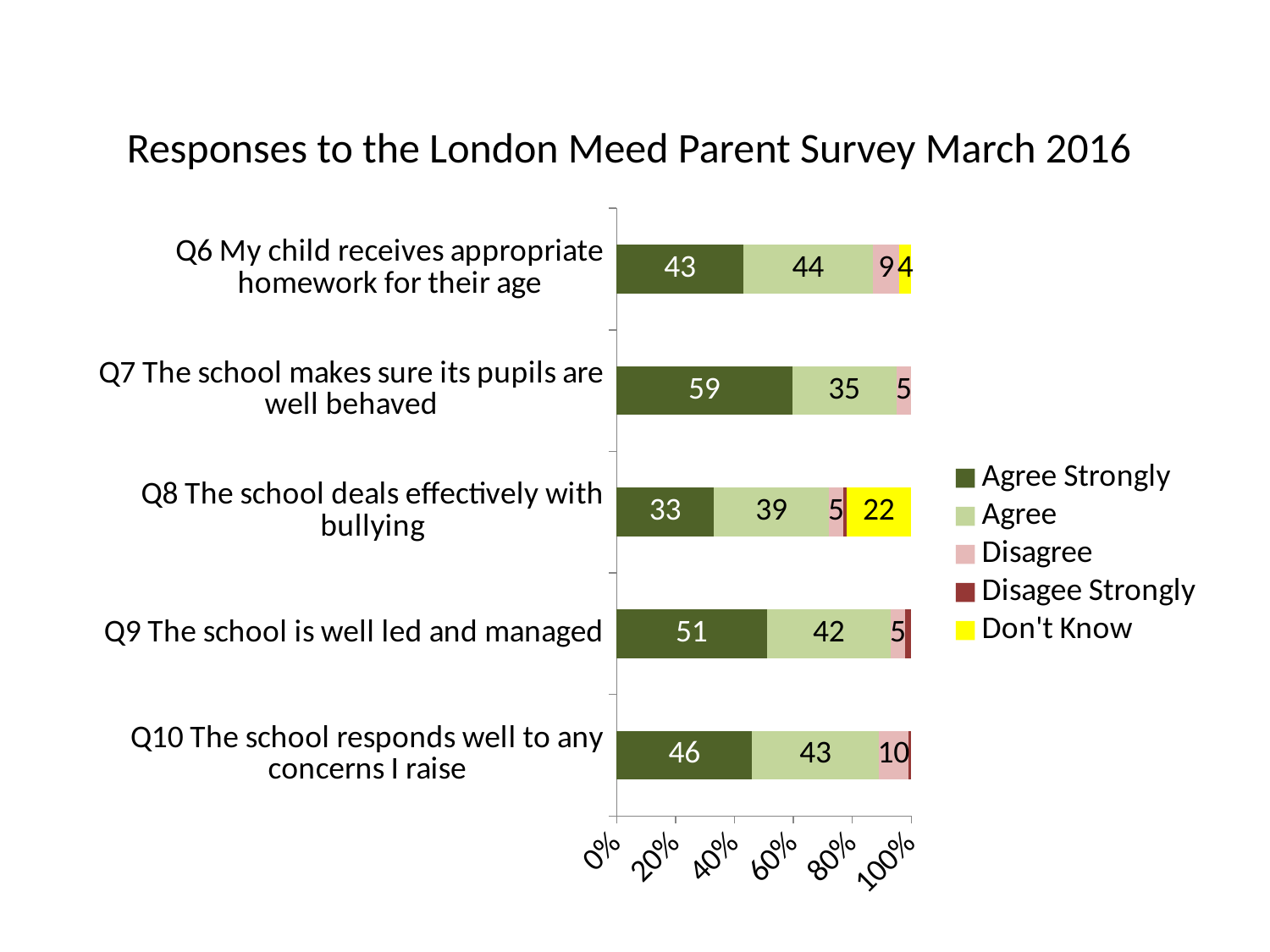
What is the Agree value for Q6 My child receives appropriate homework for their age? 44 What is the Don't Know value for Q8 The school deals effectively with bullying? 22 Which survey question has the lowest Agree Strongly value? Q8 The school deals effectively with bullying Which survey question has the highest Agree Strongly value? Q7 The school makes sure its pupils are well behaved Which is larger, the Agree Strongly value for Q9 or for Q10? Q9 What is the title of the chart? Responses to the London Meed Parent Survey March 2016 How many survey questions (categories) are plotted on the chart? 5 What type of chart is shown on the slide? Stacked bar chart What is the Agree Strongly value for Q7 The school makes sure its pupils are well behaved? 59 How many series does the legend list? 5 What is the difference between the Agree Strongly values for Q7 and Q8? 26 What is the Disagree value for Q10 The school responds well to any concerns I raise? 10